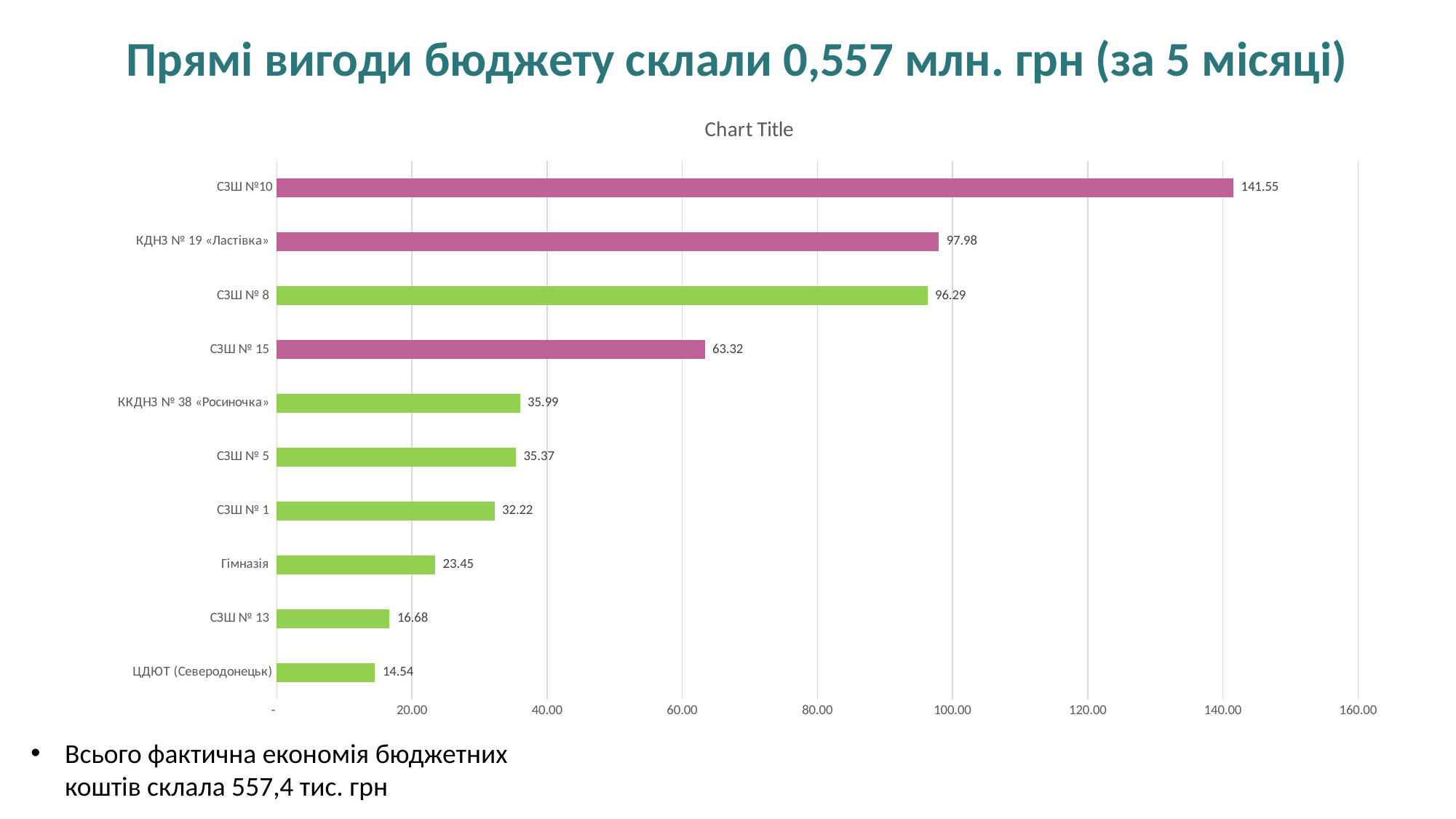
What kind of chart is shown on the slide? bar chart What is the difference between the values for СЗШ № 15 and ККДНЗ № 38 «Росиночка»? 27.33 What is the value for Гімназія? 23.45 What is the value for КДНЗ № 19 «Ластівка»? 97.98 What is the difference between the values for СЗШ №10 and КДНЗ № 19 «Ластівка»? 43.57 What is the value for ЦДЮТ (Северодонецьк)? 14.54 What is the value for СЗШ №10? 141.55 How many categories are shown in the chart? 10 Is the value for СЗШ № 15 greater or less than 60.00? greater Which category has the highest value? СЗШ №10 Which is larger, the value for СЗШ № 8 or the value for СЗШ № 15? СЗШ № 8 Which category has the lowest value? ЦДЮТ (Северодонецьк)